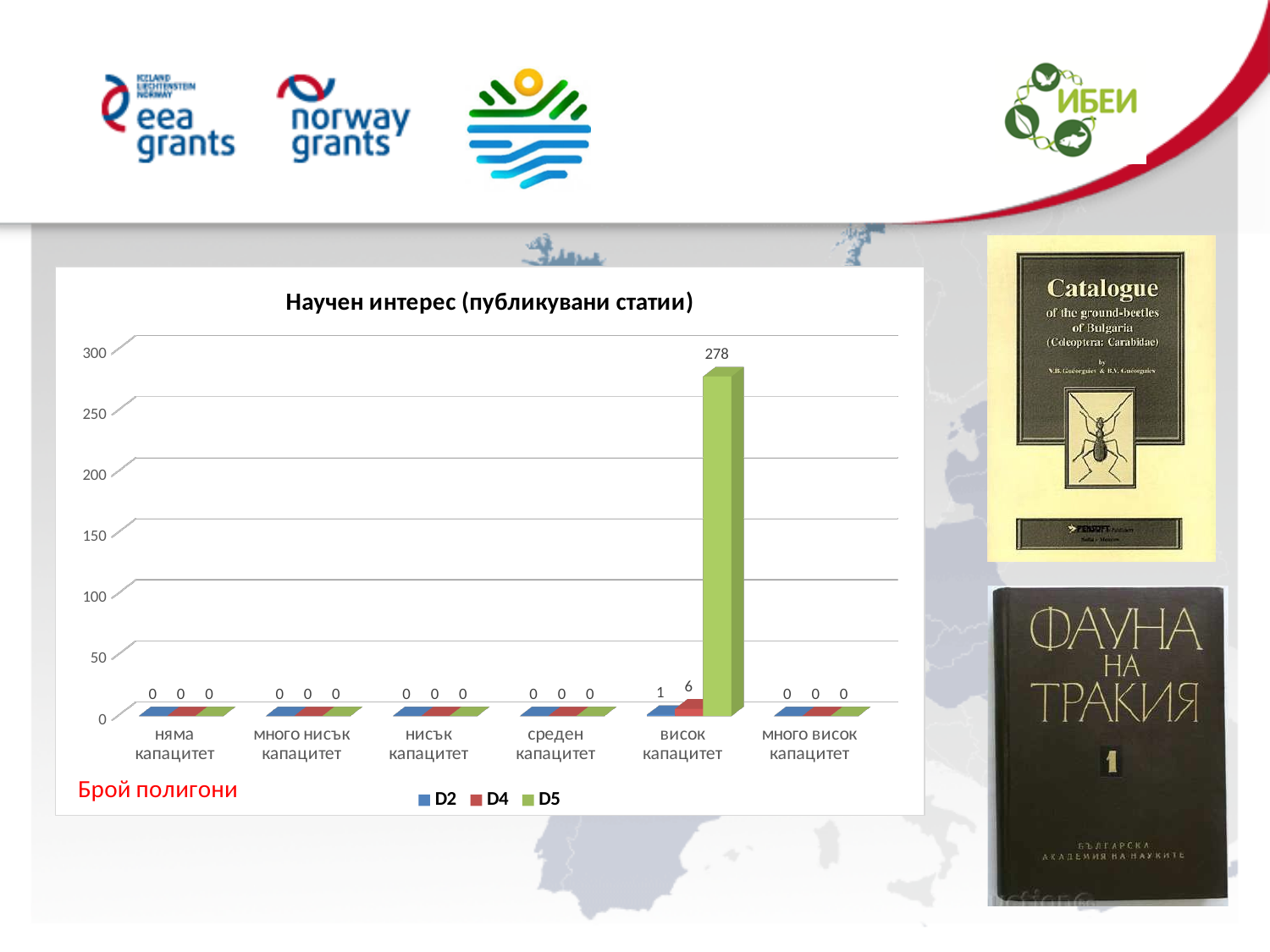
What is the value of D5 for "висок капацитет" in the chart "Научен интерес (публикувани статии)"? 278 What is the value of D4 for "висок капацитет"? 6 What is the value of D5 for "среден капацитет"? 0 Which category has the highest D5 value? висок капацитет For "висок капацитет", which is larger: the D4 value or the D2 value? D4 How many series does the legend list? 3 What is the difference between the D5 and D4 values for "висок капацитет"? 272 How many categories are shown on the x axis of the chart? 6 Is the D5 value for "висок капацитет" greater or less than 250? greater What is the value of D2 for "висок капацитет"? 1 What is the title of the chart? Научен интерес (публикувани статии) What kind of chart is shown on the slide? bar chart